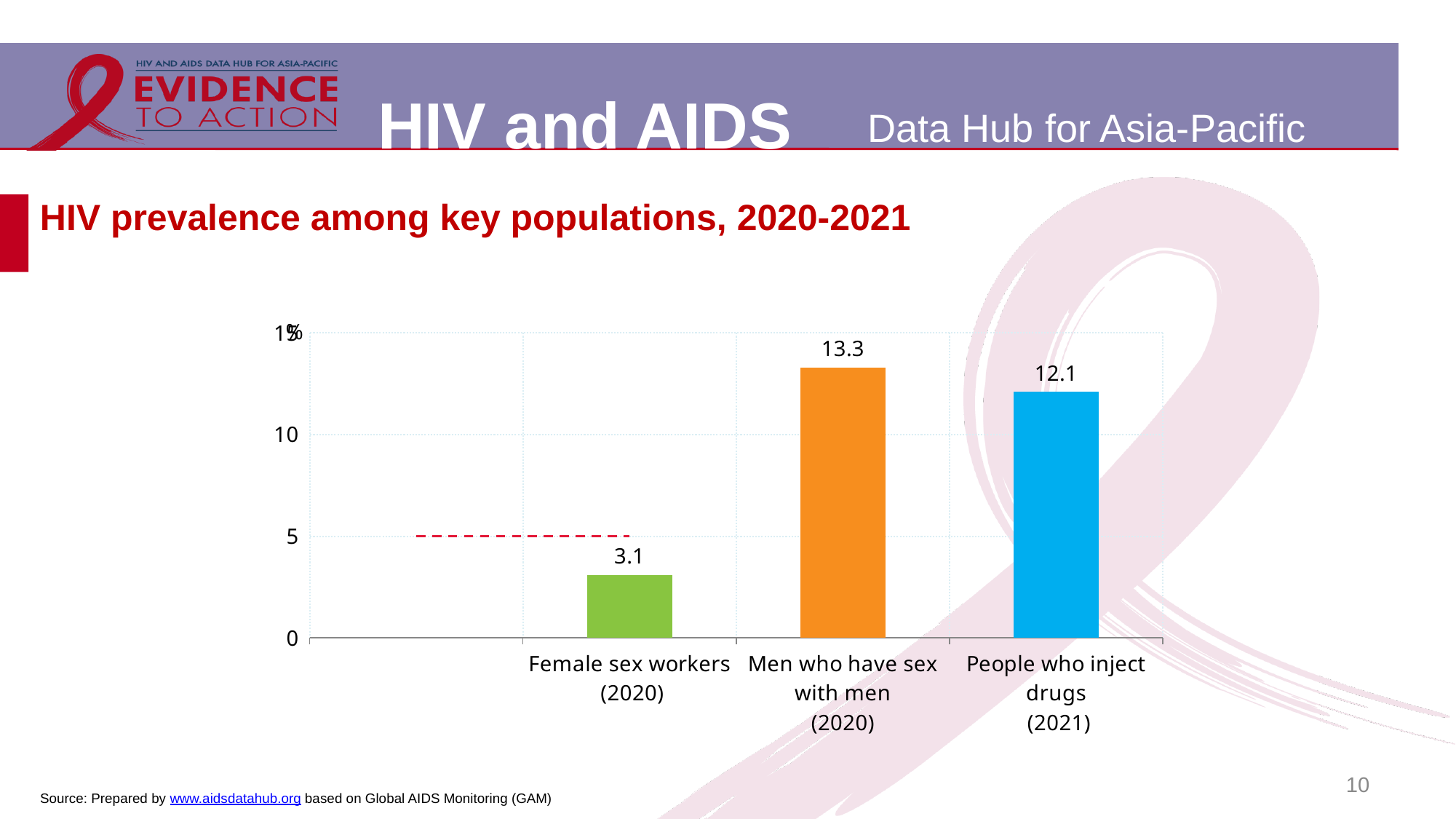
Which key population has the highest HIV prevalence? Men who have sex with men (2020) How many key populations are shown in the chart? 3 Is the value for female sex workers greater or less than 5? less What is the HIV prevalence among men who have sex with men (2020)? 13.3 What is the difference in HIV prevalence between men who have sex with men and female sex workers? 10.2 What is the HIV prevalence among people who inject drugs (2021)? 12.1 What kind of chart is shown on the slide? Bar chart What is the difference in HIV prevalence between men who have sex with men and people who inject drugs? 1.2 Which is larger: the HIV prevalence among female sex workers or among people who inject drugs? People who inject drugs What is the HIV prevalence among female sex workers (2020)? 3.1 Which key population has the lowest HIV prevalence? Female sex workers (2020) What is the title of the chart? HIV prevalence among key populations, 2020-2021